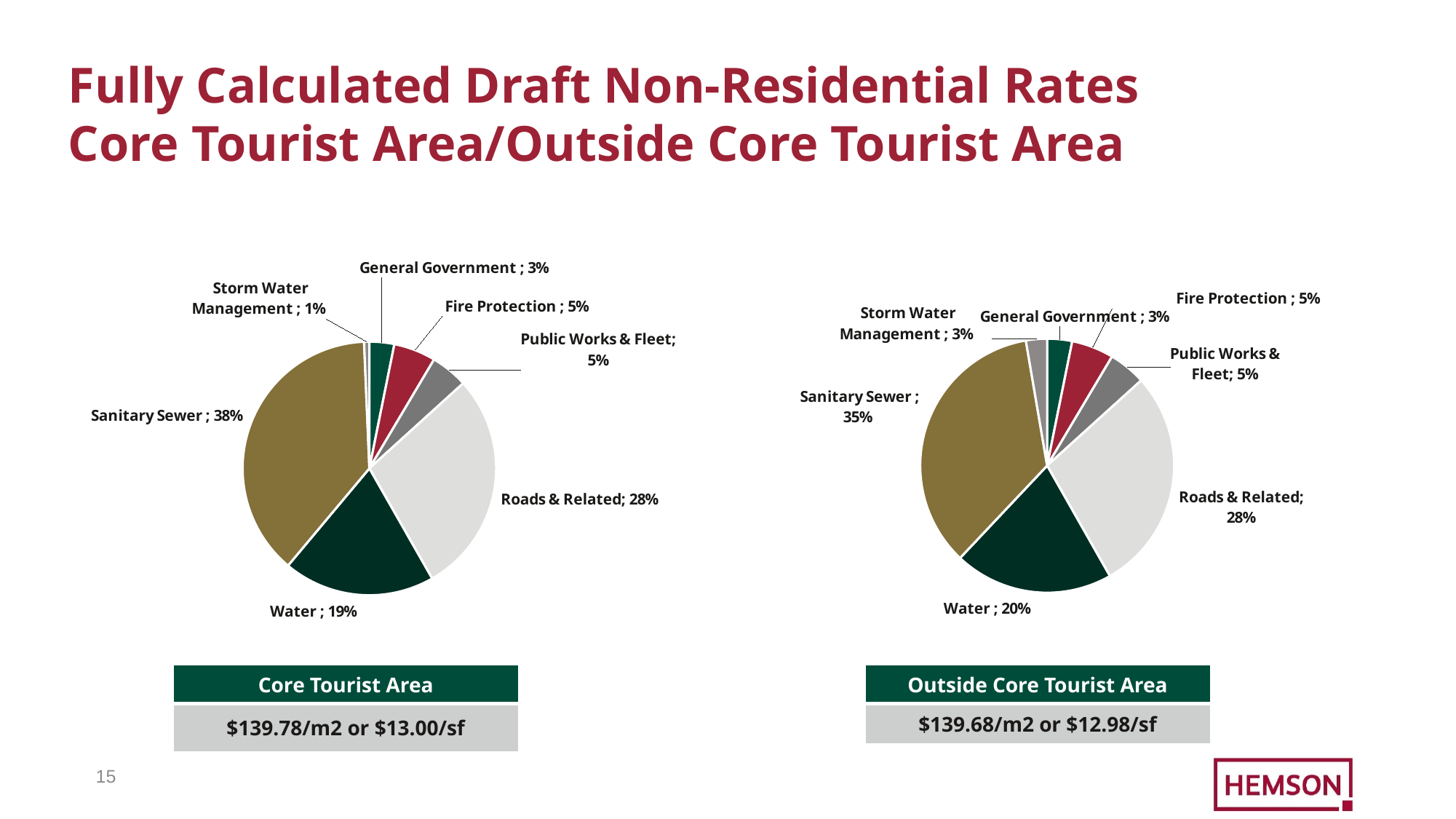
In the Core Tourist Area pie chart, what share does Sanitary Sewer have? 38% In the Core Tourist Area pie chart, which is larger: Roads & Related or Water? Roads & Related In the Core Tourist Area pie chart, which category has the smallest share? Storm Water Management In the Outside Core Tourist Area pie chart, which category has the largest share? Sanitary Sewer What is the difference between the Sanitary Sewer share in the Core Tourist Area chart and the Sanitary Sewer share in the Outside Core Tourist Area chart? 3% What type of chart is used on this slide? Pie chart What rate is shown below the Outside Core Tourist Area pie chart? $139.68/m2 or $12.98/sf In the Outside Core Tourist Area pie chart, what share does Storm Water Management have? 3% How many categories are shown in the Core Tourist Area pie chart? 7 In the Core Tourist Area pie chart, what share does Fire Protection have? 5% In the Core Tourist Area pie chart, which category has the largest share? Sanitary Sewer